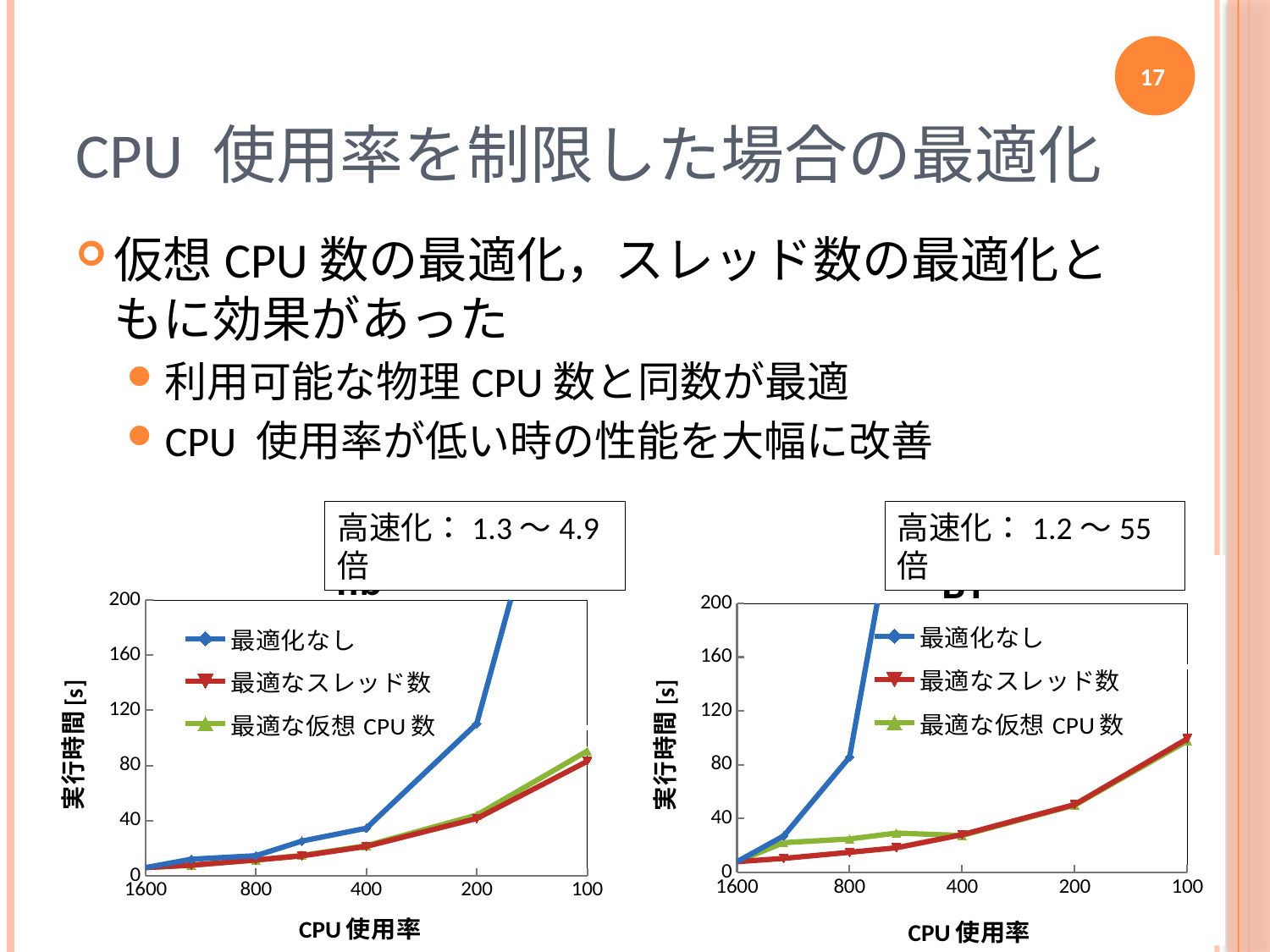
How many tick values are shown on the x axis of the left chart? 5 In the left chart, is the value of 最適化なし at CPU 使用率 200 greater or less than 80? greater How many series does the legend of the right chart list? 3 In the right chart, is the value of 最適なスレッド数 at CPU 使用率 100 greater or less than 80? greater In the left chart, is the value of 最適なスレッド数 at CPU 使用率 100 greater or less than 40? greater In the left chart, at CPU 使用率 200, which series has the larger value: 最適化なし or 最適なスレッド数? 最適化なし What kind of chart is the left chart on the slide? line chart What is the label of the y axis on the left chart? 実行時間 [s] In the right chart, does the execution time of 最適化なし rise or fall moving from left to right along the x axis? rise What is the label of the x axis on the right chart? CPU 使用率